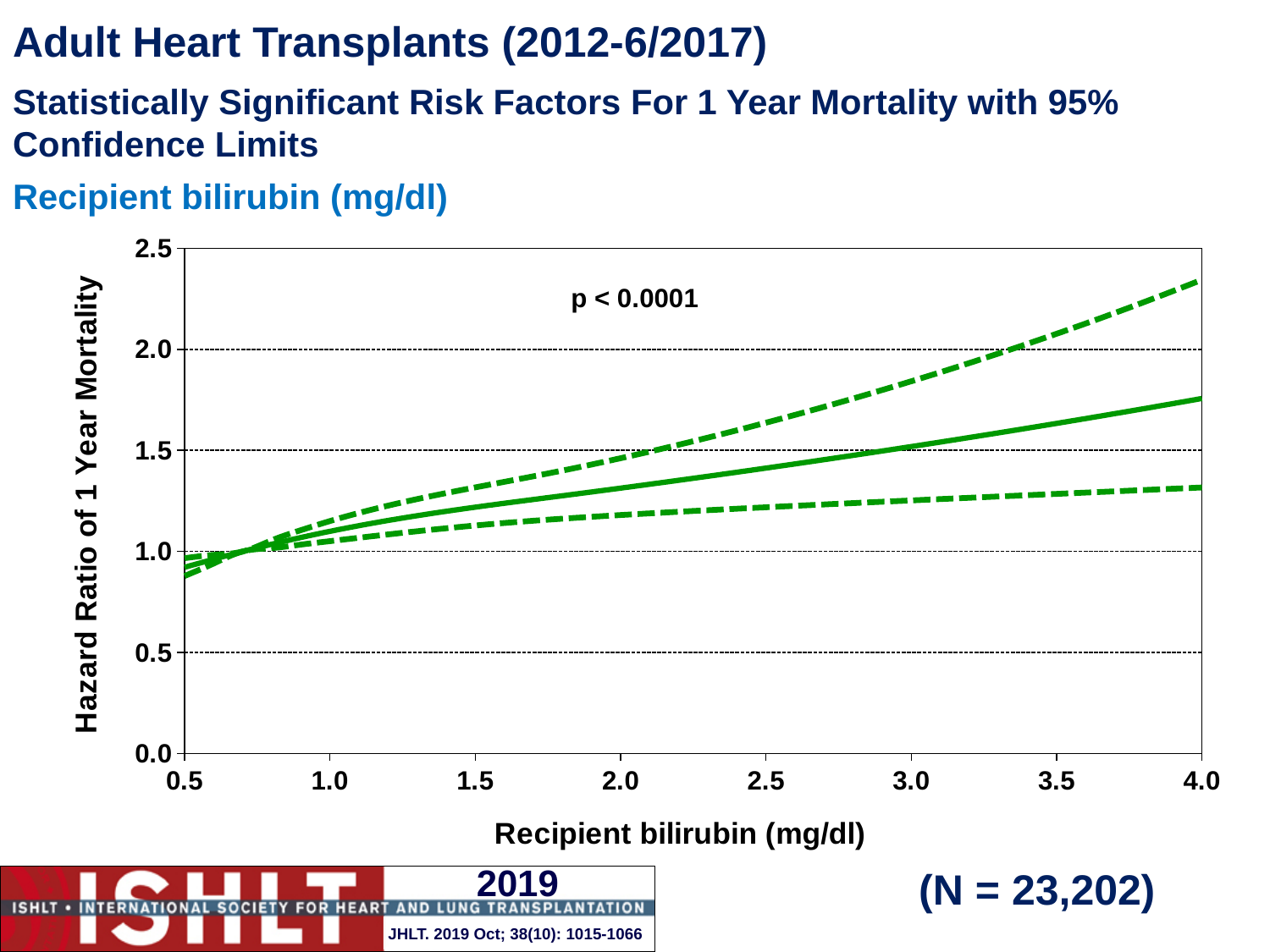
Is the lower 95% confidence limit (lower dashed line) at a recipient bilirubin of 4.0 mg/dl greater or less than 1.5? less What kind of chart is shown on the slide? line chart How many lines are plotted on the chart? 3 What is the label of the x axis? Recipient bilirubin (mg/dl) Is the upper 95% confidence limit (upper dashed line) at a recipient bilirubin of 4.0 mg/dl greater or less than 2.0? greater Does the hazard ratio (solid line) rise or fall as recipient bilirubin increases from 0.5 to 4.0 mg/dl? rise Is the hazard ratio (solid line) at a recipient bilirubin of 2.0 mg/dl greater or less than 1.5? less What p-value is printed on the chart? p < 0.0001 What is the label of the y axis? Hazard Ratio of 1 Year Mortality